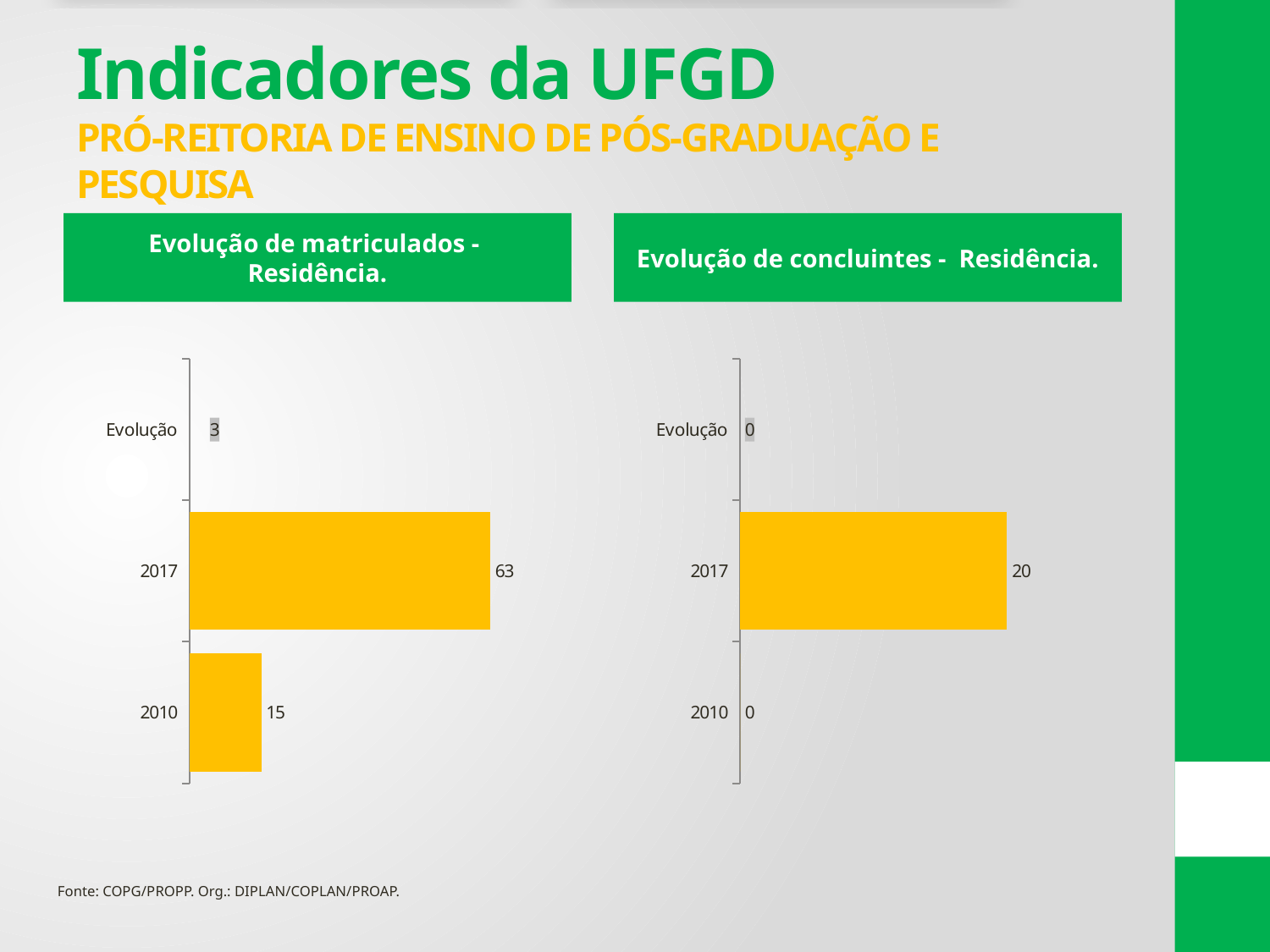
In the 'Evolução de matriculados - Residência' chart, what is the value for 2017? 63 In the 'Evolução de concluintes - Residência' chart, what is the value for 2017? 20 In the 'Evolução de matriculados - Residência' chart, what is the difference between the values for 2017 and 2010? 48 What kind of chart is the 'Evolução de matriculados - Residência' chart? Bar chart In the 'Evolução de concluintes - Residência' chart, what is the difference between the values for 2017 and 2010? 20 What is the title of the chart on the right side of the slide? Evolução de concluintes - Residência. In the 'Evolução de matriculados - Residência' chart, which category has the lowest value? Evolução In the 'Evolução de matriculados - Residência' chart, what is the value for 2010? 15 In the 'Evolução de matriculados - Residência' chart, which category has the highest value? 2017 In the 'Evolução de concluintes - Residência' chart, what is the value for 2010? 0 In the 'Evolução de matriculados - Residência' chart, which is larger, the value for 2010 or the value for 2017? 2017 How many categories are shown in the 'Evolução de concluintes - Residência' chart? 3